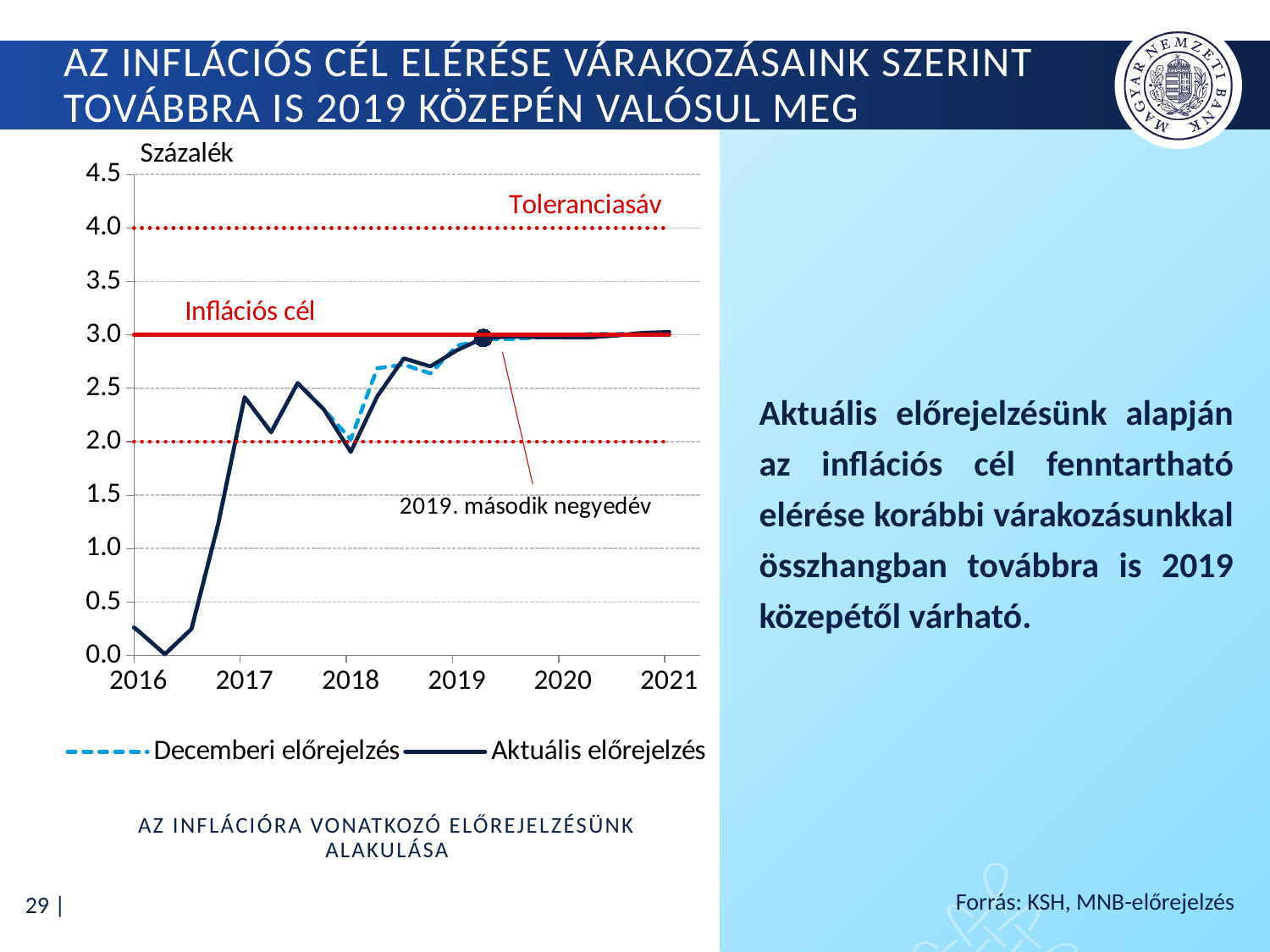
What are the two series named in the legend? Decemberi előrejelzés and Aktuális előrejelzés What period does the annotation with the red arrow point to? 2019. második negyedév Is the value of 'Aktuális előrejelzés' at the start of 2017 greater or less than 2.0? greater How many year labels are shown on the x axis? 6 At what level is the lower 'Toleranciasáv' line drawn? 2.0 At what level is the 'Inflációs cél' line drawn? 3.0 How many series does the legend list? 2 Is the value of 'Aktuális előrejelzés' at the start of 2020 greater or less than 2.5? greater At what level is the upper 'Toleranciasáv' line drawn? 4.0 Is the value of 'Aktuális előrejelzés' at the start of 2016 greater or less than 0.5? less Does the 'Aktuális előrejelzés' line rise or fall between 2016 and 2017? rise What kind of chart is shown on the slide? line chart